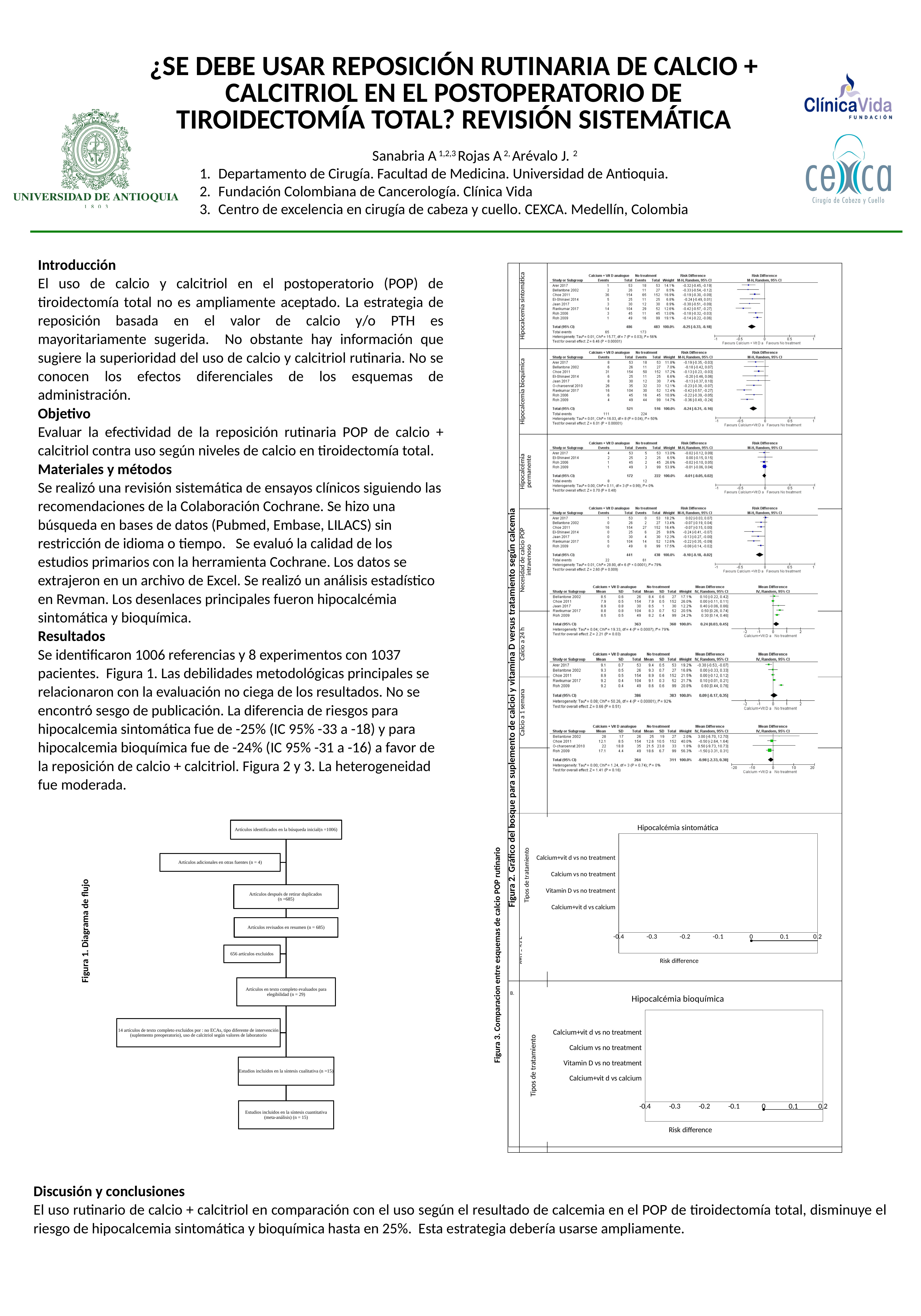
In the forest plot of Figura 2, what is the pooled risk difference (Total 95% CI) for the 'Hipocalcemia permanente' subgroup? -0.01 [-0.05, 0.02] In the forest plot of Figura 2, what is the pooled risk difference (Total 95% CI) for the 'Hipocalcemia bioquímica' subgroup? -0.24 [-0.31, -0.16] In the 'Hipocalcémia sintomática' chart of Figura 3, what is the label of the horizontal axis? Risk difference In Figura 3, what is the title of the lower chart? Hipocalcémia bioquímica In the 'Hipocalcémia sintomática' chart of Figura 3, how many treatment comparison categories are listed on the vertical axis? 4 In the forest plot of Figura 2, what is the pooled risk difference (Total 95% CI) for the 'Hipocalcemia sintomática' subgroup? -0.25 [-0.33, -0.18] In the 'Hipocalcémia sintomática' chart of Figura 3, what is the lowest value shown on the horizontal axis? -0.4 In the 'Hipocalcémia bioquímica' chart of Figura 3, how many treatment comparison categories are listed on the vertical axis? 4 In the forest plot of Figura 2, how many studies are included in the 'Hipocalcemia permanente' subgroup? 4